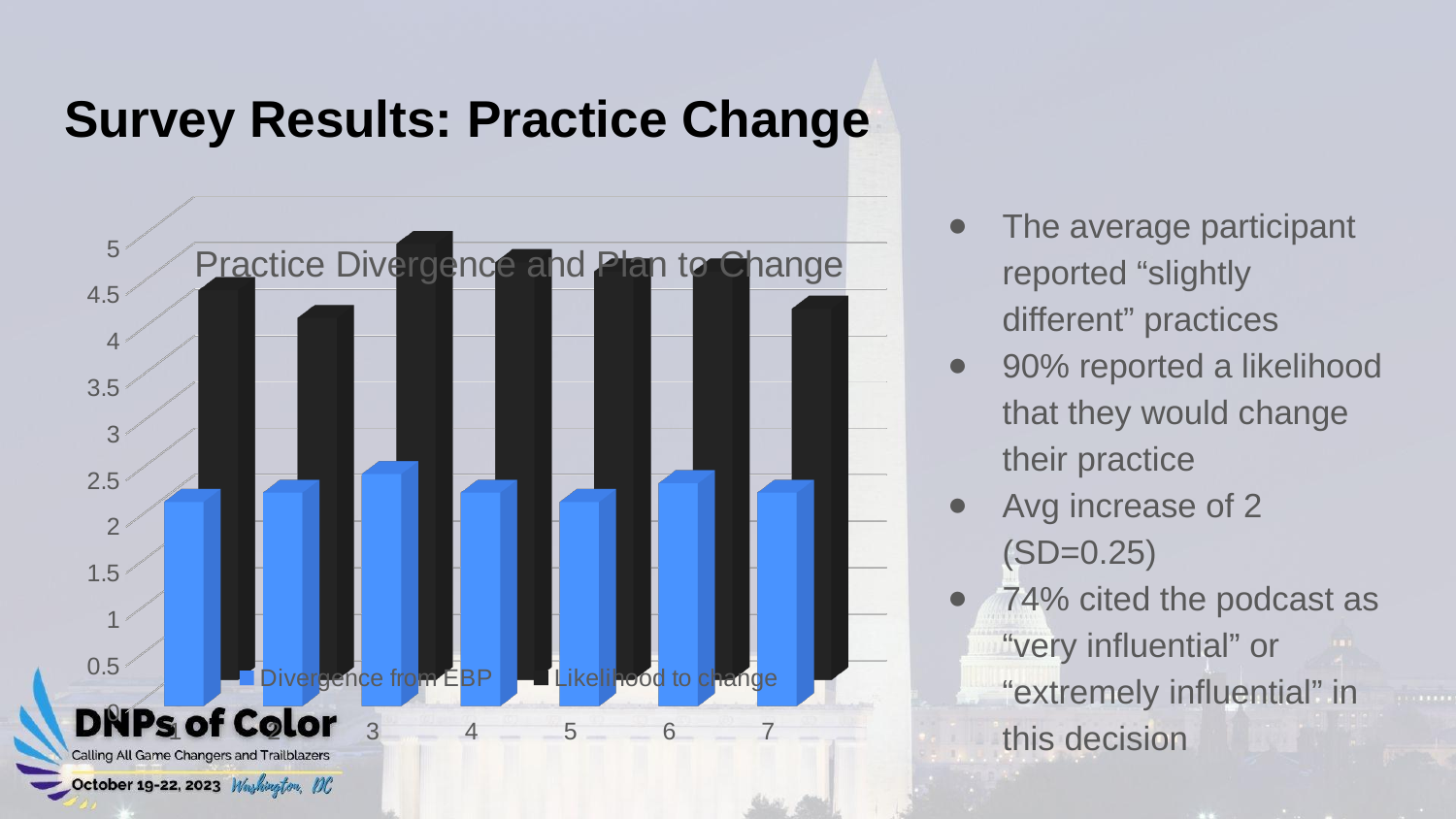
Is the Likelihood to change value for category 1 greater or less than 4? greater What kind of chart is shown on the slide? bar chart Is the Divergence from EBP value for category 5 greater or less than 3? less How many categories are shown along the x axis of the chart? 7 Which series is shown in blue in the chart? Divergence from EBP For category 3, which series has the larger value: Divergence from EBP or Likelihood to change? Likelihood to change What is the title of the chart on the slide? Practice Divergence and Plan to Change For category 7, which series has the larger value: Divergence from EBP or Likelihood to change? Likelihood to change How many series does the chart's legend list? 2 Is the Likelihood to change value for category 7 greater or less than 5? less Which category has the highest Likelihood to change value? 3